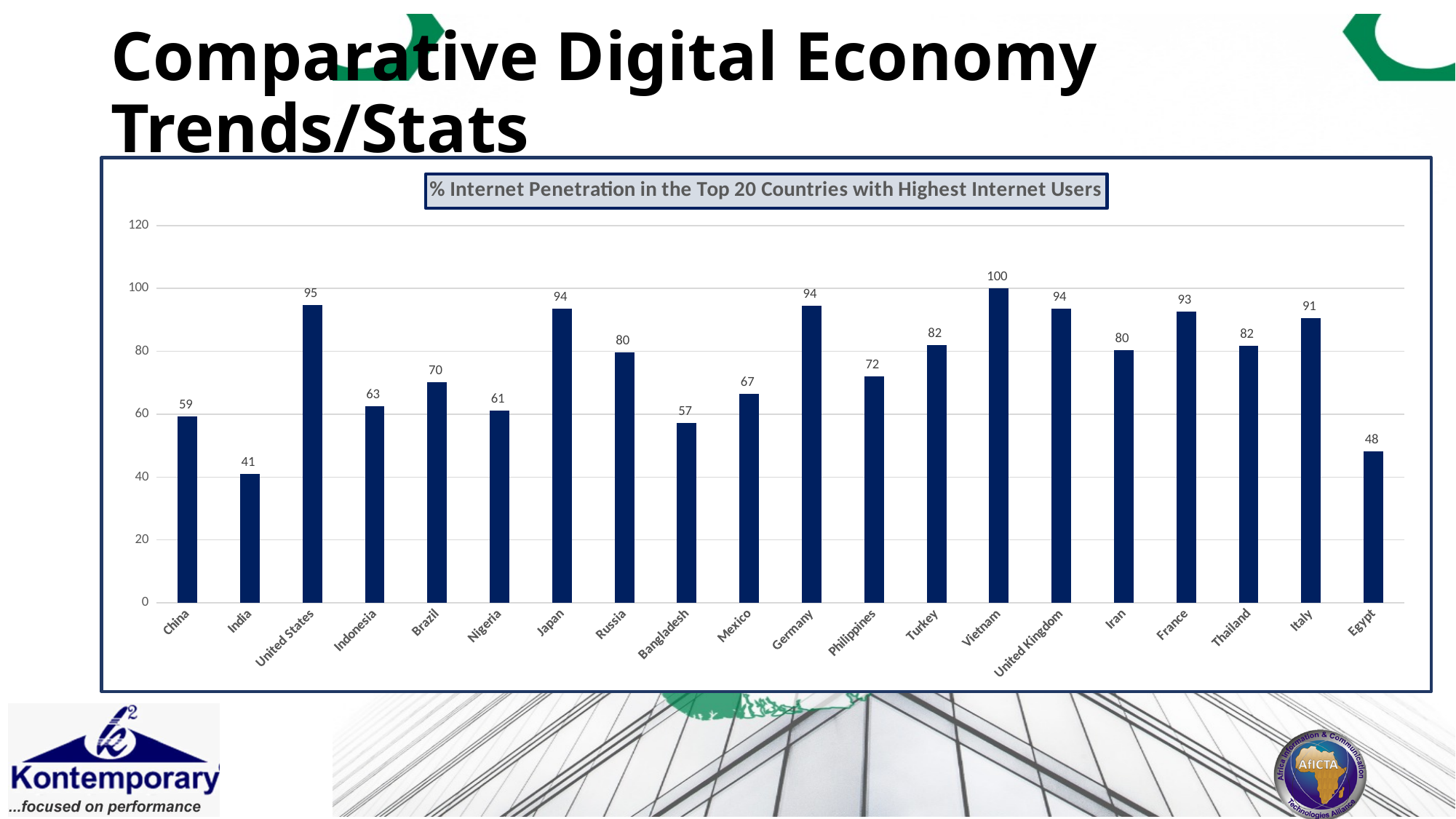
Which has a higher value, Brazil or Egypt? Brazil What is the value shown for Nigeria? 61 How many countries are shown in the chart? 20 Is the value for Bangladesh greater or less than 60? less What is the internet penetration value shown for Vietnam? 100 What is the difference between the values for Japan and Russia? 14 Which country has the lowest internet penetration in the chart? India What is the internet penetration value shown for India? 41 Which country has the highest internet penetration in the chart? Vietnam What kind of chart is shown on the slide? Bar chart What is the title of the chart? % Internet Penetration in the Top 20 Countries with Highest Internet Users What is the difference between the values for the United States and China? 36